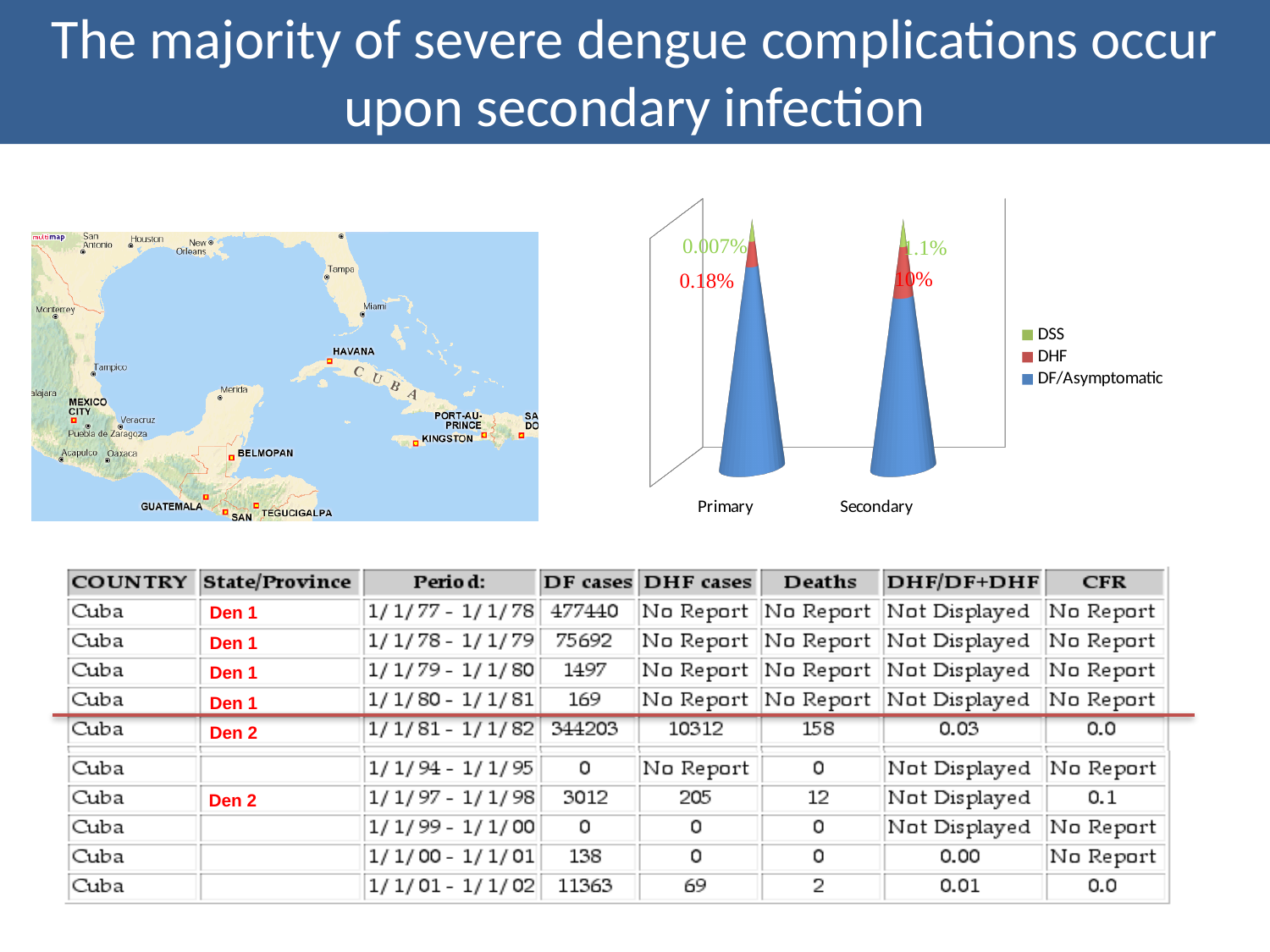
Which series makes up the smallest portion of the Secondary bar? DSS Which category has the larger DHF share, Primary or Secondary? Secondary How many series does the chart's legend list? 3 In the chart, what is the DHF value shown for Secondary? 10% Which series makes up the largest portion of the Primary bar? DF/Asymptomatic What kind of chart is shown on the slide? bar chart What colour represents DF/Asymptomatic in the chart? blue How many categories are shown on the x axis of the chart? 2 Which category has the larger DSS share, Primary or Secondary? Secondary What are the series names listed in the chart's legend? DSS, DHF, DF/Asymptomatic In the chart, what is the DSS value shown for Primary? 0.007% In the chart, what is the DHF value shown for Primary? 0.18%